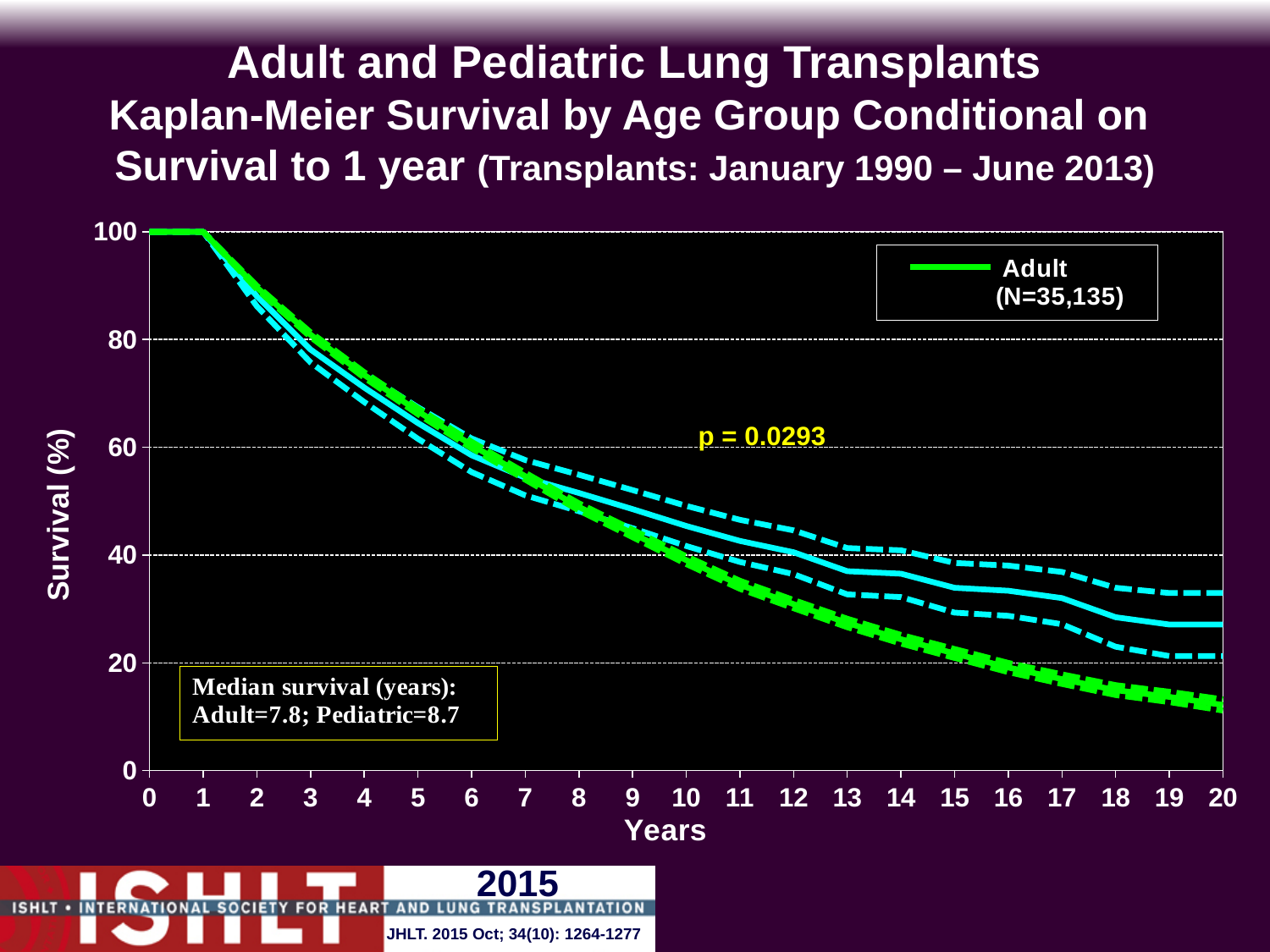
What p-value is printed on the chart? p = 0.0293 What kind of chart is shown on the slide? line chart What is the label of the y-axis? Survival (%) Which group has the longer median survival, Adult or Pediatric? Pediatric What is the N for the Adult group shown in the legend? N=35,135 What is the difference in median survival (years) between the Pediatric and Adult groups? 0.9 Does the Adult survival curve rise or fall as the years increase? fall Is the Adult survival at year 2 greater or less than 80? greater Is the Adult survival at year 20 greater or less than 20? less Is the Adult survival at year 12 greater or less than 40? less What is the median survival in years for the Adult group? 7.8 What is the median survival in years for the Pediatric group? 8.7